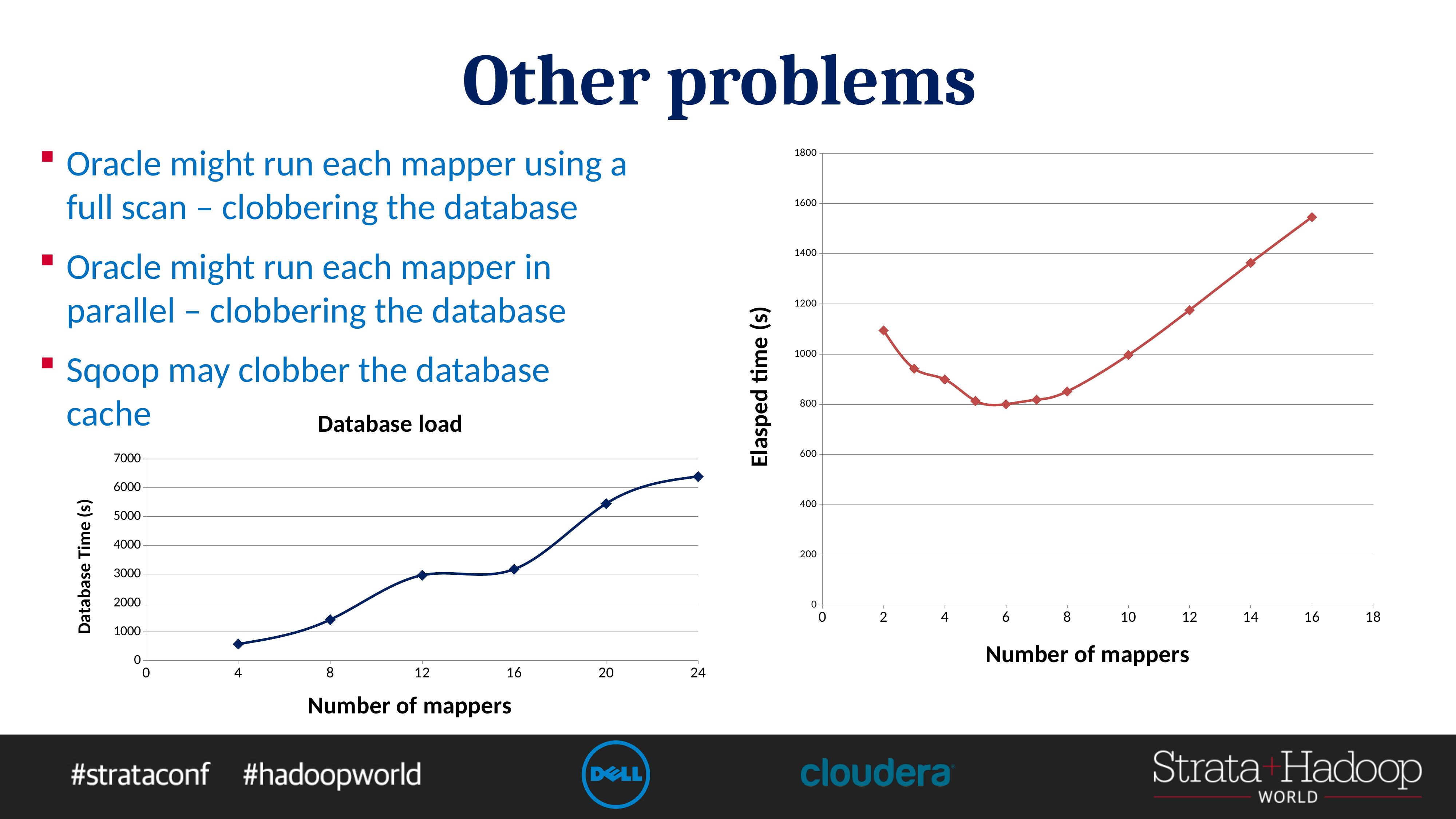
How many data points are plotted on the 'Database load' chart? 6 On the chart on the right, is the elapsed time for 6 mappers greater or less than 1000? less What kind of chart is the 'Database load' chart on the left? line chart What is the y-axis label of the 'Database load' chart? Database Time (s) On the 'Database load' chart, at which number of mappers is the database time highest? 24 On the 'Database load' chart, is the database time for 24 mappers greater or less than 6000? greater On the chart on the right, is the elapsed time for 16 mappers greater or less than 1400? greater On the 'Database load' chart, does the database time rise or fall as the number of mappers increases? rise On the chart on the right, at which number of mappers is the elapsed time highest? 16 On the 'Database load' chart, at which number of mappers is the database time lowest? 4 How many data points are plotted on the chart on the right (Elasped time vs Number of mappers)? 11